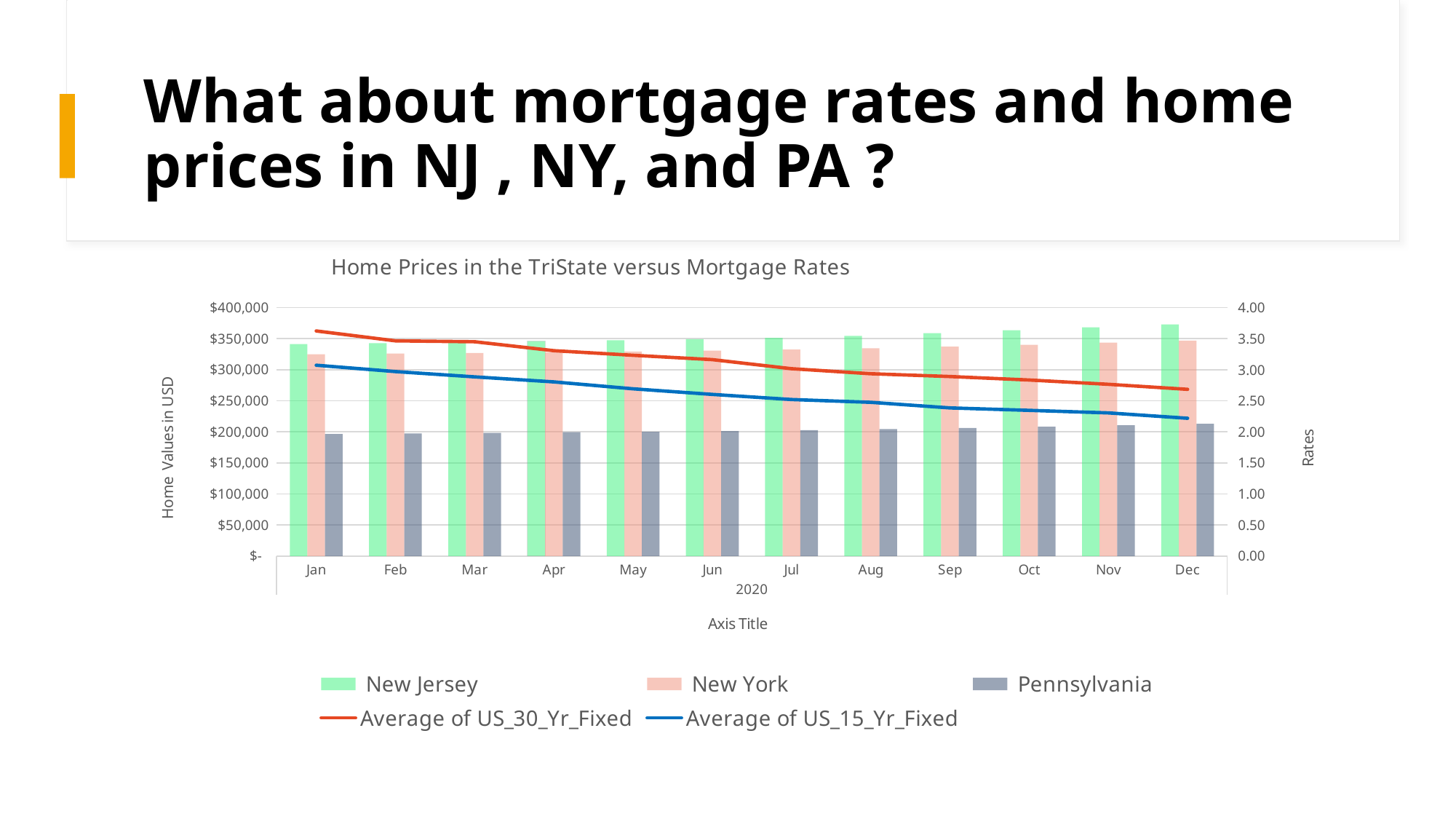
Is the Average of US_15_Yr_Fixed rate for Dec greater or less than 2.50? less Does the Average of US_30_Yr_Fixed line rise or fall from Jan to Dec? Fall Is the Average of US_30_Yr_Fixed rate for Jan greater or less than 3.50? greater Which state has the lowest home value in Jan? Pennsylvania Which state has the highest home value in Dec? New Jersey What is the title of the chart? Home Prices in the TriState versus Mortgage Rates How many months are shown along the x axis? 12 Is the New Jersey home value for Dec greater or less than $350,000? greater How many series does the legend list? 5 What kind of chart is shown on the slide? A combination bar and line chart Does the Average of US_15_Yr_Fixed line rise or fall across 2020? Fall